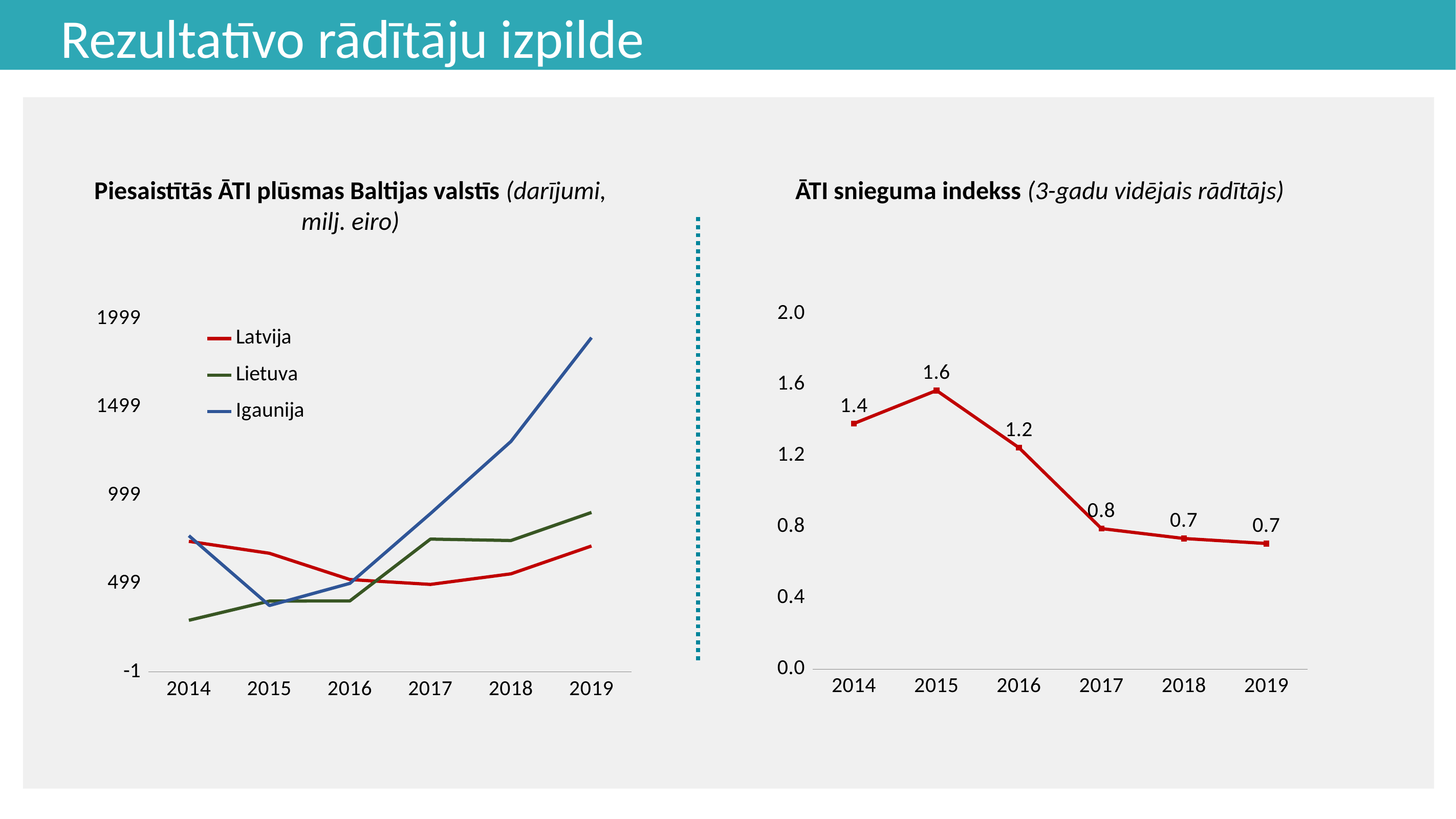
On the chart titled 'ĀTI snieguma indekss', how many years are plotted? 6 On the left chart 'Piesaistītās ĀTI plūsmas Baltijas valstīs', is the value for Lietuva in 2014 greater or less than 499? less On the chart titled 'ĀTI snieguma indekss', which is larger, the value for 2014 or the value for 2016? 2014 On the chart titled 'ĀTI snieguma indekss', do the values rise or fall from 2015 to 2019? fall On the left chart 'Piesaistītās ĀTI plūsmas Baltijas valstīs', is the value for Igaunija in 2019 greater or less than 1499? greater On the chart titled 'ĀTI snieguma indekss', what is the value for 2015? 1.6 On the left chart 'Piesaistītās ĀTI plūsmas Baltijas valstīs', how many series does the legend list? 3 What kind of chart is the left chart 'Piesaistītās ĀTI plūsmas Baltijas valstīs'? line chart On the left chart 'Piesaistītās ĀTI plūsmas Baltijas valstīs', which series has the higher value in 2019, Igaunija or Latvija? Igaunija On the chart titled 'ĀTI snieguma indekss', what is the difference between the 2015 and 2016 values? 0.4 On the chart titled 'ĀTI snieguma indekss', which year has the highest value? 2015 On the chart titled 'ĀTI snieguma indekss', what is the value for 2017? 0.8